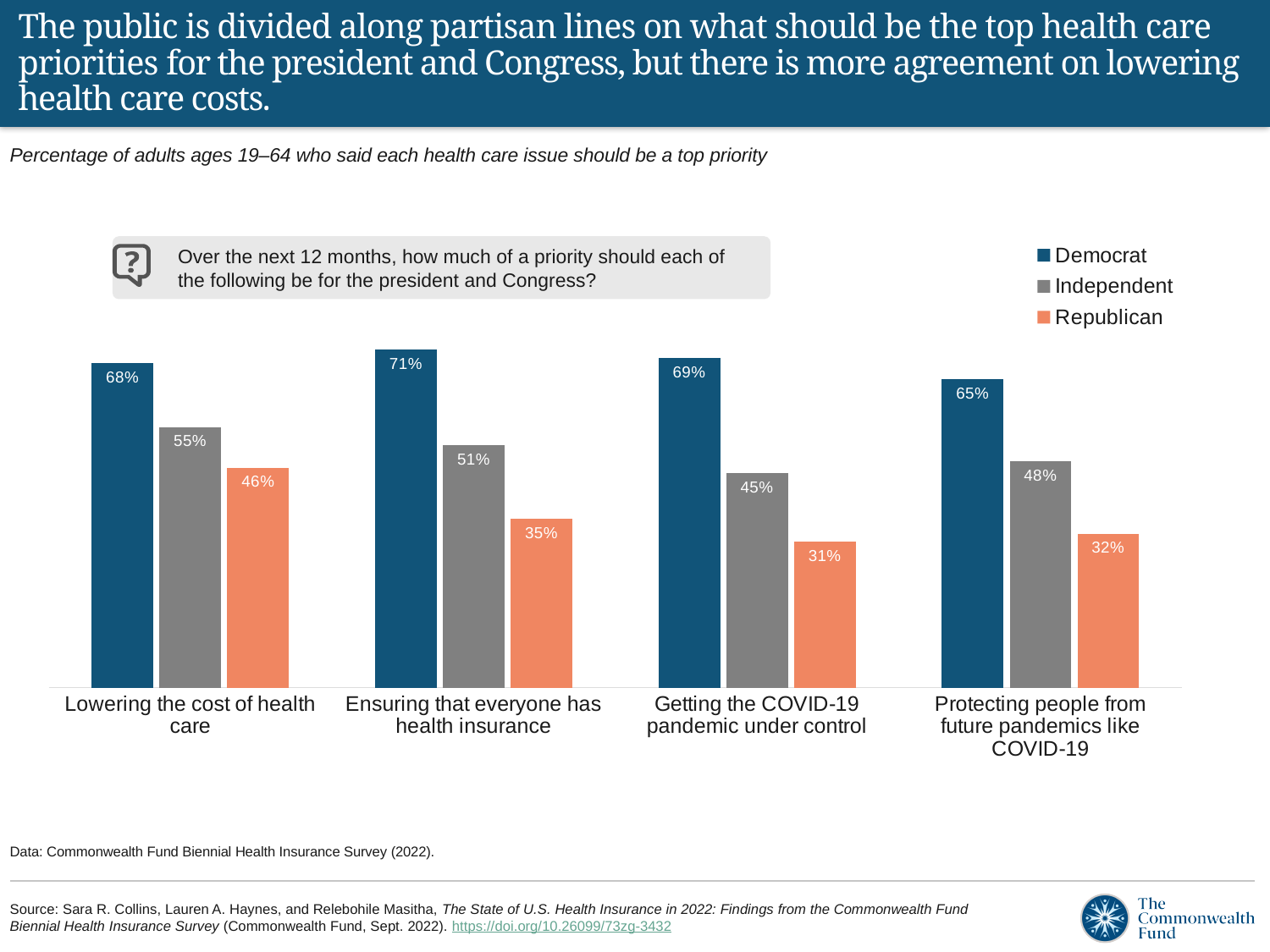
How many health care issues are shown on the x axis? 4 What is the difference between the Democrat and Independent values for getting the COVID-19 pandemic under control? 24 percentage points What percentage of Independents said getting the COVID-19 pandemic under control should be a top priority? 45% How many series does the legend list? 3 Which series is shown in orange in the legend? Republican What kind of chart is shown on the slide? Bar chart Which health care issue has the highest Democrat value? Ensuring that everyone has health insurance Which is larger: the Independent value for lowering the cost of health care or the Independent value for ensuring that everyone has health insurance? Lowering the cost of health care Which health care issue has the lowest Republican value? Getting the COVID-19 pandemic under control What is the difference between the Democrat and Republican values for protecting people from future pandemics like COVID-19? 33 percentage points What percentage of Democrats said lowering the cost of health care should be a top priority? 68% What percentage of Republicans said ensuring that everyone has health insurance should be a top priority? 35%